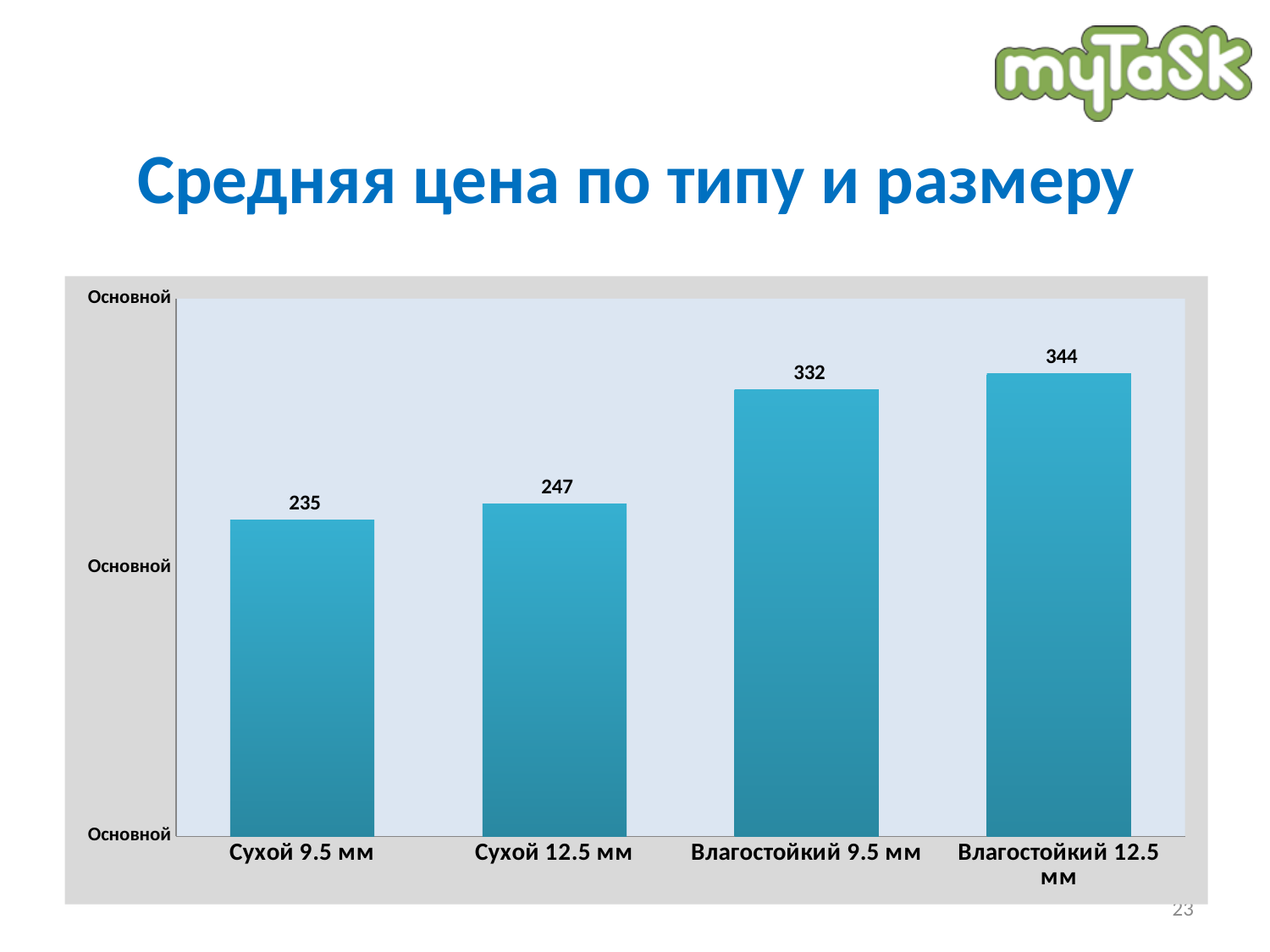
Which category has the lowest value? Сухой 9.5 мм Which is larger, the value for Сухой 12.5 мм or the value for Влагостойкий 9.5 мм? Влагостойкий 9.5 мм What is the difference between the values for Влагостойкий 12.5 мм and Сухой 12.5 мм? 97 What is the difference between the values for Влагостойкий 9.5 мм and Сухой 9.5 мм? 97 How many categories are shown on the chart? 4 What kind of chart is shown on the slide? Bar chart Which category has the highest value? Влагостойкий 12.5 мм What is the value for Влагостойкий 9.5 мм? 332 What is the value for Сухой 9.5 мм? 235 What is the title of the slide? Средняя цена по типу и размеру What is the value for Влагостойкий 12.5 мм? 344 What is the value for Сухой 12.5 мм? 247